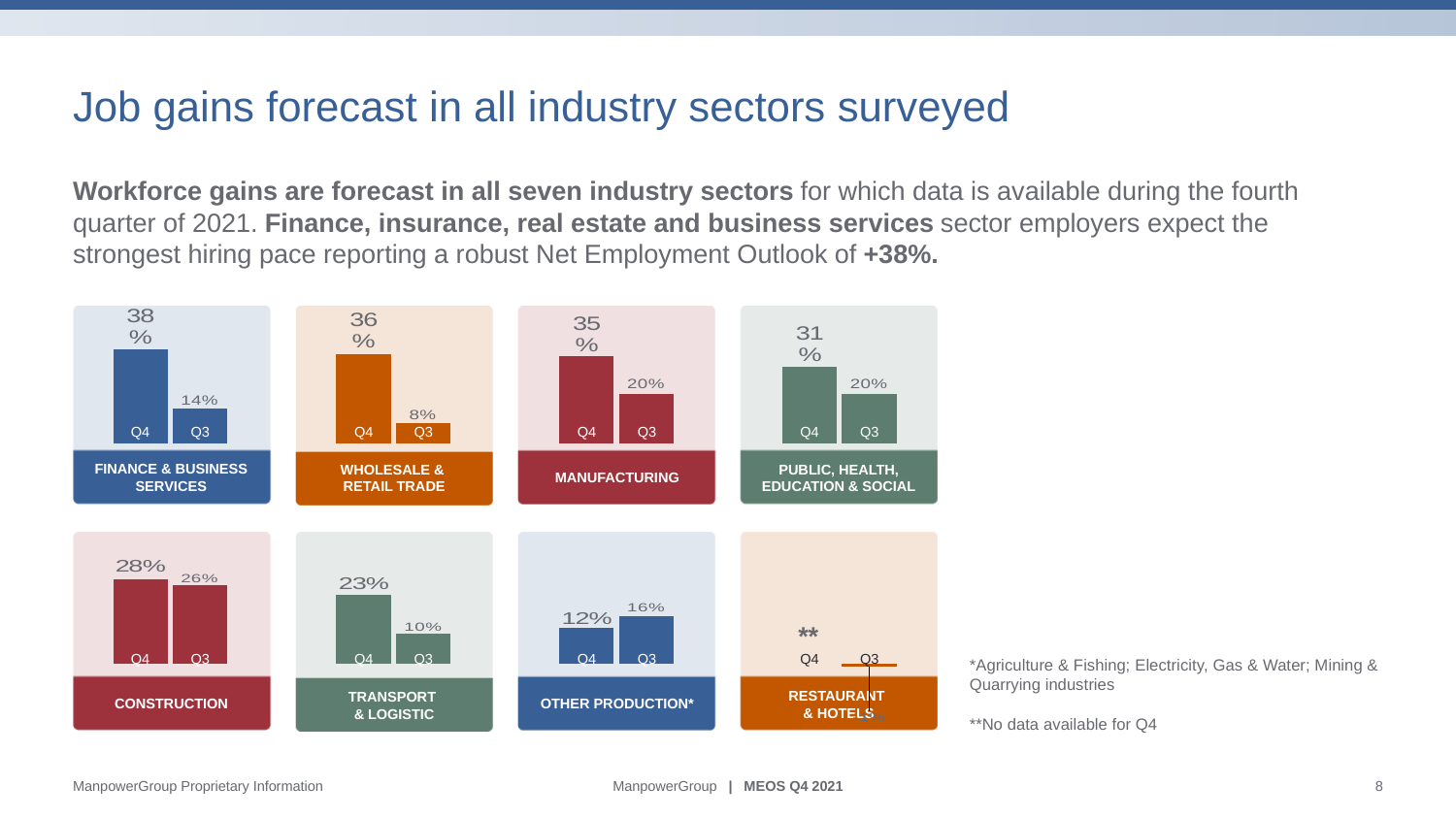
In the Wholesale & Retail Trade chart, what is the difference between the Q4 and Q3 values? 28% In the Manufacturing chart, what is the value for Q4? 35% In the Wholesale & Retail Trade chart, what is the value for Q3? 8% What type of chart is used for the Manufacturing sector? Bar chart In the Finance & Business Services chart, what is the value for Q4? 38% In the Construction chart, what is the difference between the Q4 and Q3 values? 2% In the Public, Health, Education & Social chart, what is the value for Q3? 20% In the Finance & Business Services chart, how many bars are plotted? 2 Which sector chart shows no data available for Q4? Restaurant & Hotels In the Other Production chart, which quarter has the larger value, Q4 or Q3? Q3 In the Transport & Logistic chart, what is the value for Q4? 23% In the Transport & Logistic chart, which quarter has the larger value, Q4 or Q3? Q4